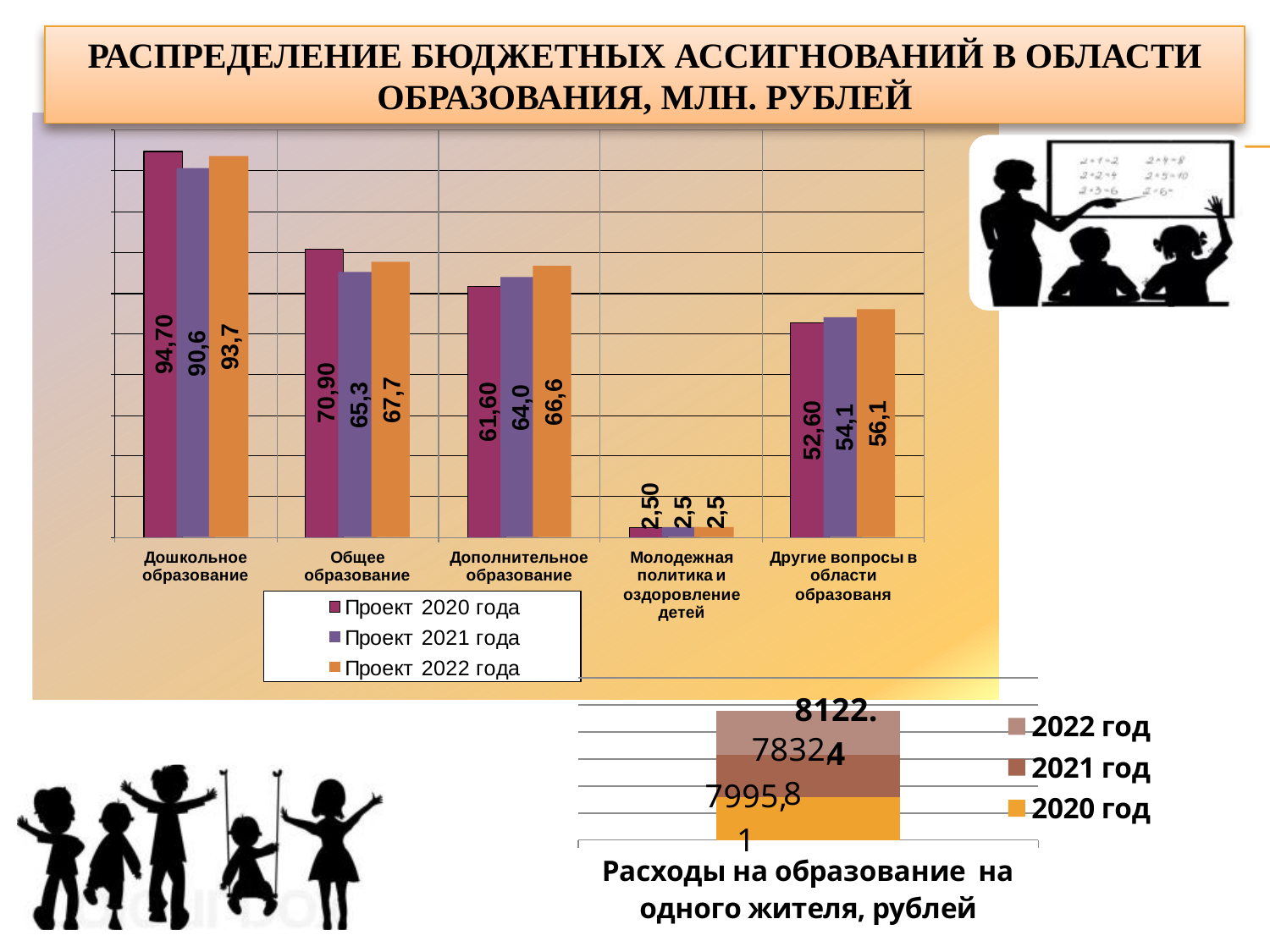
In the bottom chart (Расходы на образование на одного жителя, рублей), what is the value for 2021 год? 7832,8 In the bottom chart (Расходы на образование на одного жителя, рублей), what is the value for 2020 год? 7995,1 In the top chart, which category has the lowest value in the Проект 2020 года series? Молодежная политика и оздоровление детей In the top chart, how many series does the legend list? 3 In the top chart, what is the value for Общее образование in the Проект 2022 года series? 67,7 In the top chart, what is the difference between the Проект 2020 года and Проект 2021 года values for Общее образование? 5,6 In the top chart, what is the value for Дошкольное образование in the Проект 2020 года series? 94,70 In the top chart, how many categories are shown on the x axis? 5 In the top chart, what is the value for Дополнительное образование in the Проект 2021 года series? 64,0 What kind of chart is the top chart? bar chart In the top chart, which category has the highest value in the Проект 2022 года series? Дошкольное образование In the top chart, which is larger for Другие вопросы в области образованя: the Проект 2021 года value or the Проект 2022 года value? Проект 2022 года